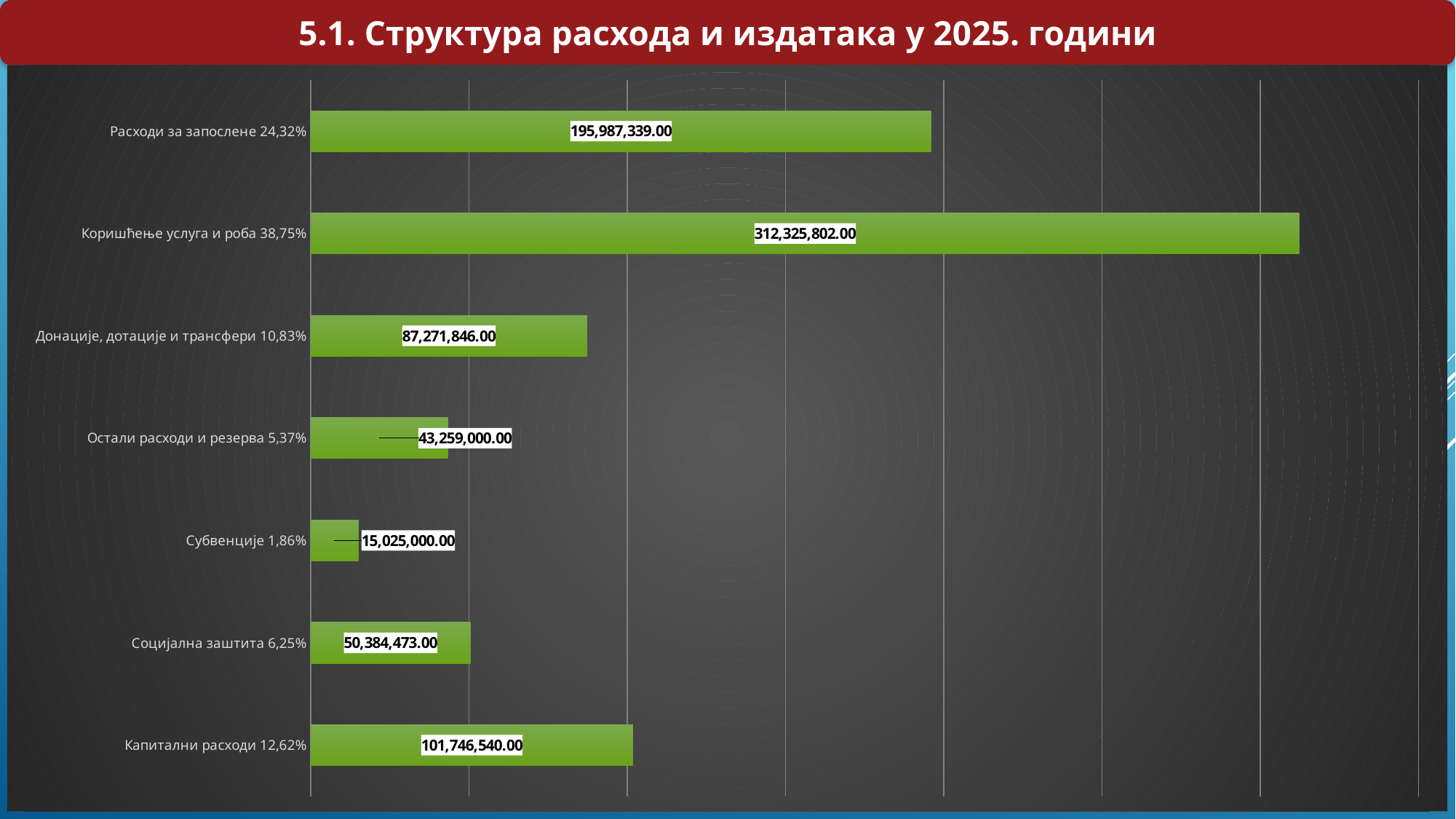
What is the title of the slide? 5.1. Структура расхода и издатака у 2025. години Which is larger, the value for Социјална заштита 6,25% or the value for Остали расходи и резерва 5,37%? Социјална заштита 6,25% Which category has the lowest value? Субвенције 1,86% How many categories are shown in the chart? 7 What kind of chart is shown on the slide? Bar chart What is the value for Расходи за запослене 24,32%? 195,987,339.00 What is the difference between the values for Коришћење услуга и роба 38,75% and Расходи за запослене 24,32%? 116,338,463.00 Which category has the highest value? Коришћење услуга и роба 38,75% What is the value for Капитални расходи 12,62%? 101,746,540.00 What is the value for Коришћење услуга и роба 38,75%? 312,325,802.00 What is the value for Субвенције 1,86%? 15,025,000.00 What is the difference between the values for Капитални расходи 12,62% and Донације, дотације и трансфери 10,83%? 14,474,694.00